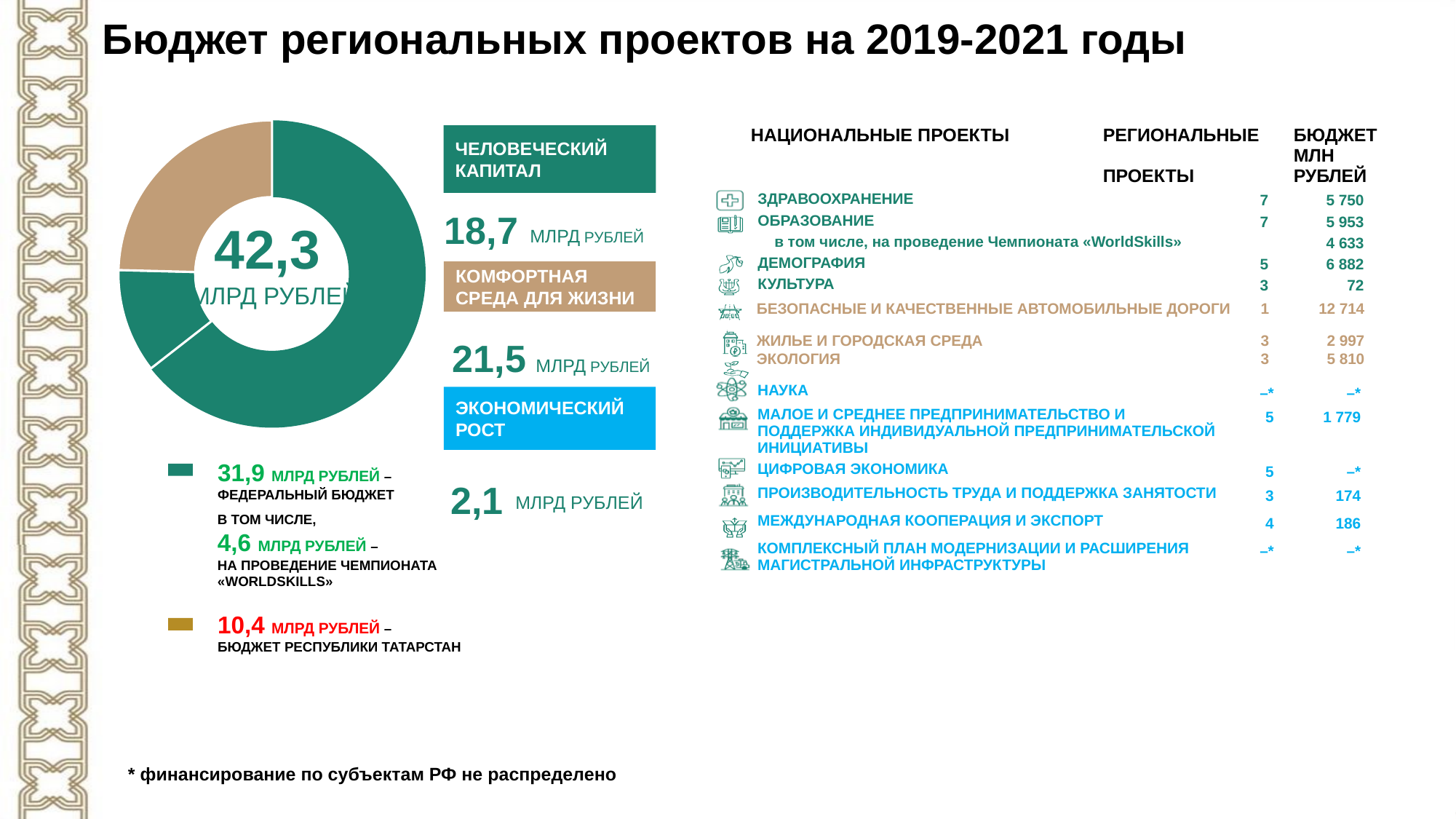
What is the difference between ЧЕЛОВЕЧЕСКИЙ КАПИТАЛ and ЭКОНОМИЧЕСКИЙ РОСТ? 16,6 МЛРД РУБЛЕЙ What is the value for ЭКОНОМИЧЕСКИЙ РОСТ? 2,1 МЛРД РУБЛЕЙ What kind of chart is shown on the slide? Donut (pie) chart What is the difference between КОМФОРТНАЯ СРЕДА ДЛЯ ЖИЗНИ and ЧЕЛОВЕЧЕСКИЙ КАПИТАЛ? 2,8 МЛРД РУБЛЕЙ Which category has the highest value in the donut chart? ФЕДЕРАЛЬНЫЙ БЮДЖЕТ What is the value for КОМФОРТНАЯ СРЕДА ДЛЯ ЖИЗНИ? 21,5 МЛРД РУБЛЕЙ How many categories are shown in the donut chart? 3 What is the total value shown in the centre of the donut chart? 42,3 МЛРД РУБЛЕЙ What is the title of the slide containing the chart? Бюджет региональных проектов на 2019-2021 годы What is the value for ЧЕЛОВЕЧЕСКИЙ КАПИТАЛ? 18,7 МЛРД РУБЛЕЙ Which is larger, ЧЕЛОВЕЧЕСКИЙ КАПИТАЛ or ЭКОНОМИЧЕСКИЙ РОСТ? ЧЕЛОВЕЧЕСКИЙ КАПИТАЛ